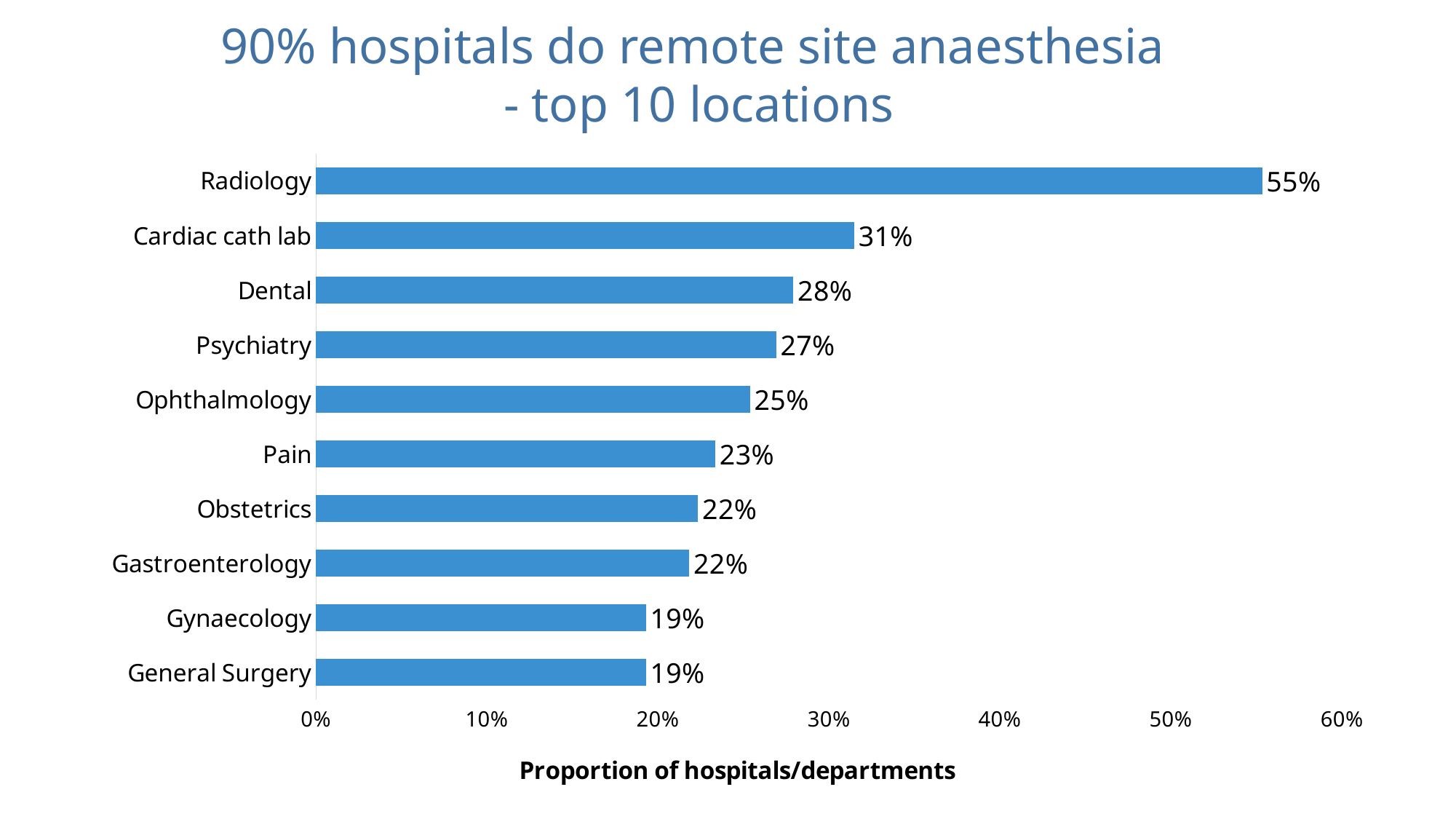
What is the value for Cardiac cath lab? 31% Which location has the highest value? Radiology What is the value for Radiology? 55% What kind of chart is shown on the slide? Bar chart What is the difference between the values for Dental and Pain? 5% What is the value for Ophthalmology? 25% What is the difference between the values for Radiology and Cardiac cath lab? 24% What is the label on the horizontal axis of the chart? Proportion of hospitals/departments Which is larger, the value for Psychiatry or the value for Obstetrics? Psychiatry How many locations are shown in the chart? 10 Is the value for Radiology greater or less than 50%? greater What is the value for Gynaecology? 19%